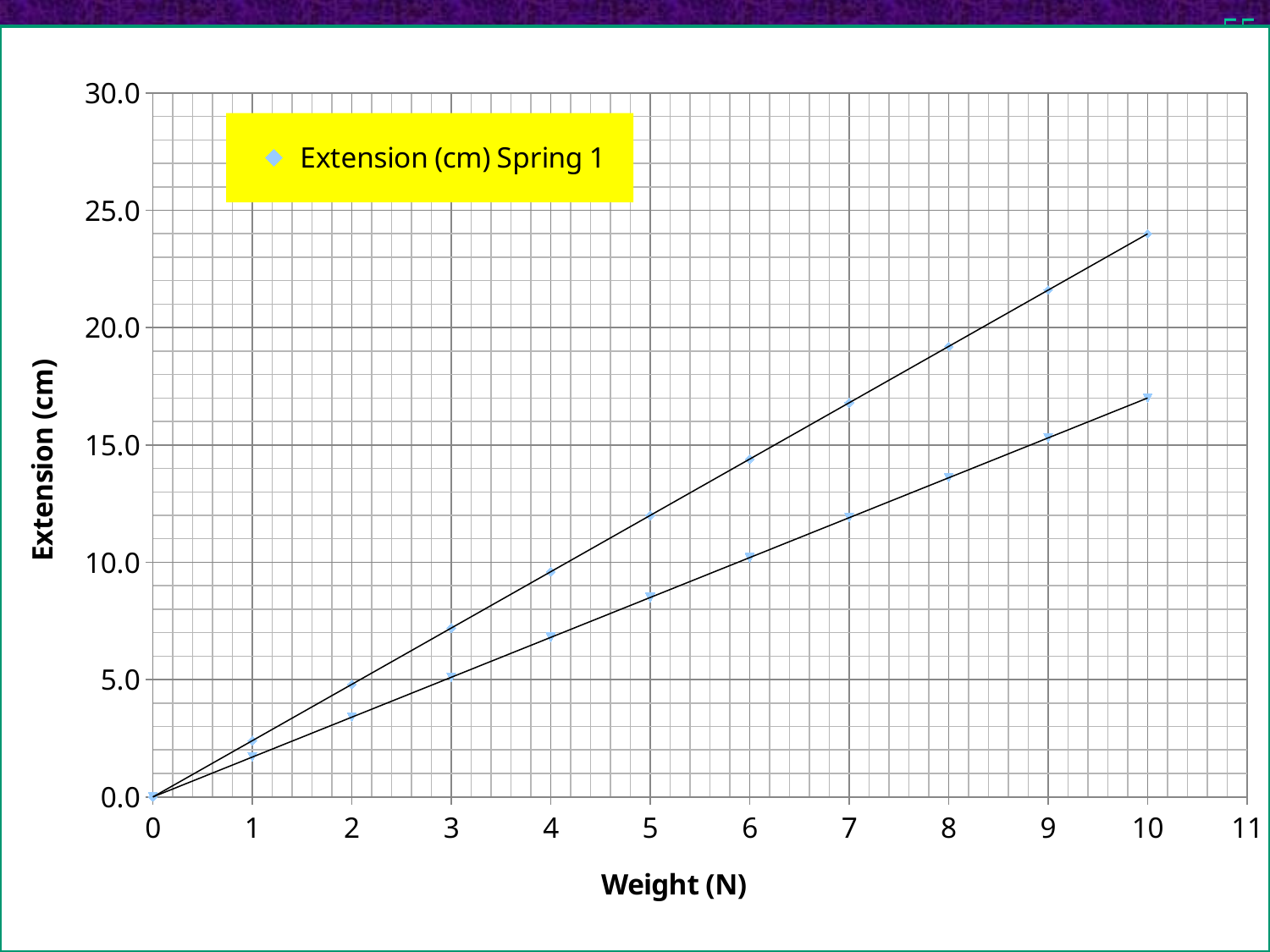
How many data points are plotted on each line, from 0 N to 10 N? 11 Is the extension of the lower line at 5 N greater or less than 10.0 cm? less Is the extension of the upper line at 5 N greater or less than 10.0 cm? greater What is the label of the y axis? Extension (cm) What kind of chart is shown on the slide? line chart What is the extension at a weight of 0 N? 0.0 How many series does the legend list? 1 At a weight of 10 N, which line shows the larger extension, the upper line or the lower line? the upper line What is the label of the x axis? Weight (N) Is the extension of the lower line at 10 N greater or less than 20.0 cm? less Do the extension values rise or fall as weight increases along the x axis? rise